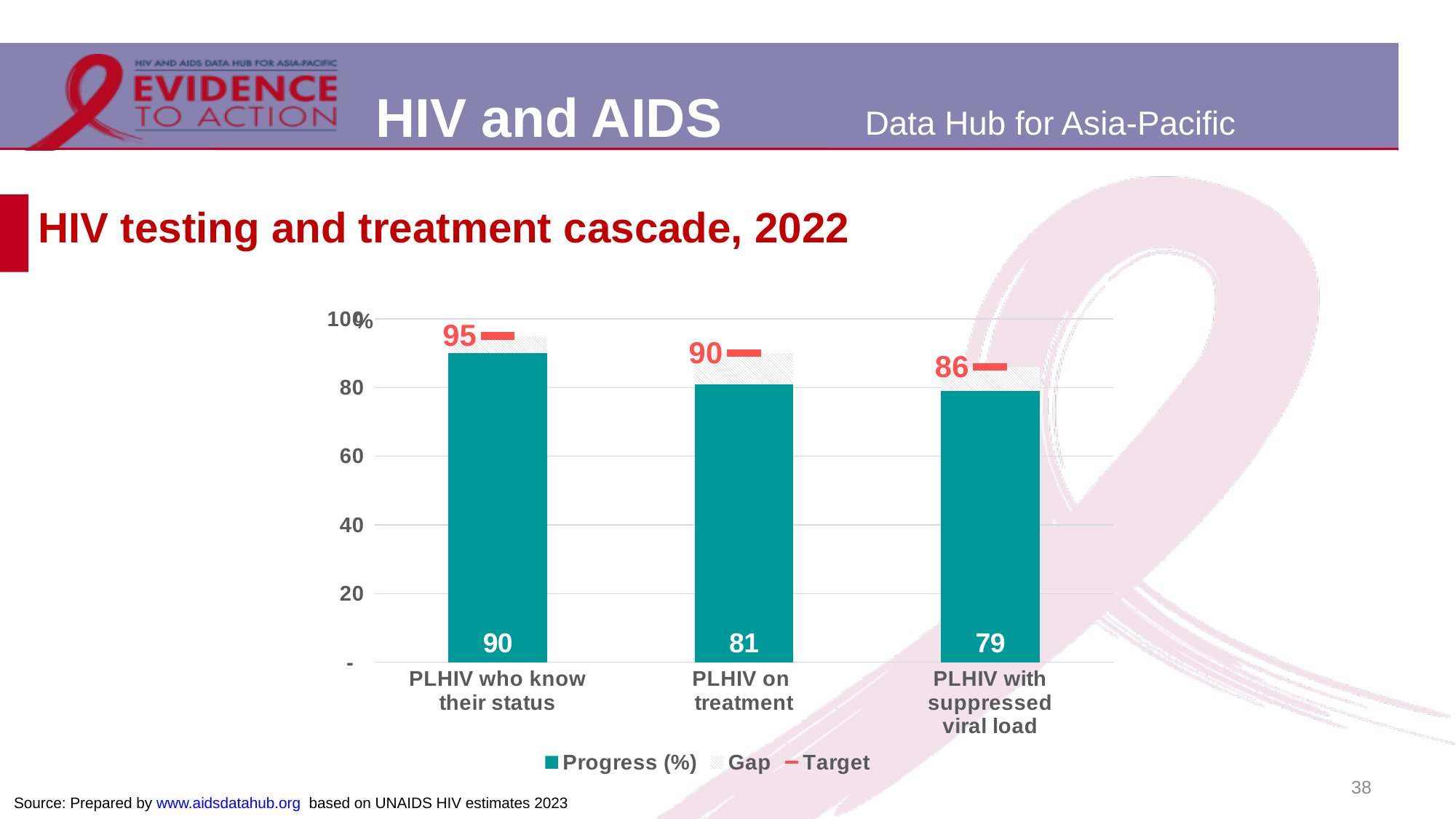
Which category has the highest Progress (%) value? PLHIV who know their status Do the Progress (%) values rise or fall from left to right across the categories? fall What is the difference between the Target and the Progress (%) for PLHIV who know their status? 5 What is the Progress (%) value for PLHIV with suppressed viral load? 79 Is the Progress (%) for PLHIV on treatment greater or less than the Progress (%) for PLHIV with suppressed viral load? greater What is the Progress (%) value for PLHIV on treatment? 81 What is the Target value shown for PLHIV with suppressed viral load? 86 What is the Target value shown for PLHIV on treatment? 90 How many categories are shown on the x axis of the chart? 3 What is the Progress (%) value for PLHIV who know their status? 90 How many series does the chart legend list? 3 Which category has the lowest Progress (%) value? PLHIV with suppressed viral load